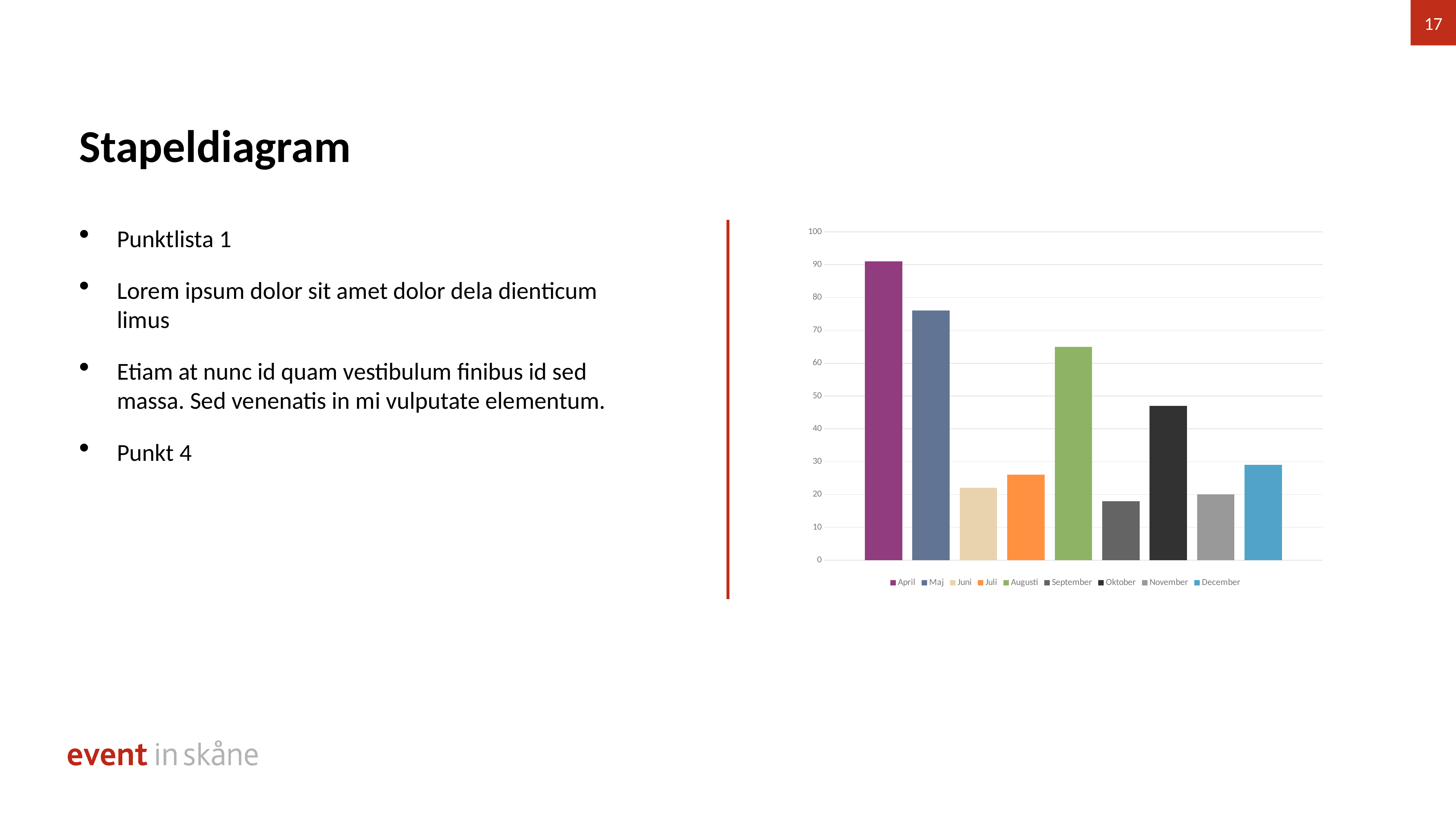
Is the value for September greater or less than 30? less What kind of chart is shown on the slide? bar chart Is the value for Maj greater or less than 70? greater Which series has the highest bar in the chart? April Which is larger, the value for April or the value for Maj? April Is the value for Oktober greater or less than 50? less How many series does the chart legend list? 9 What is the title of the slide containing the chart? Stapeldiagram Which is larger, the value for Augusti or the value for Oktober? Augusti